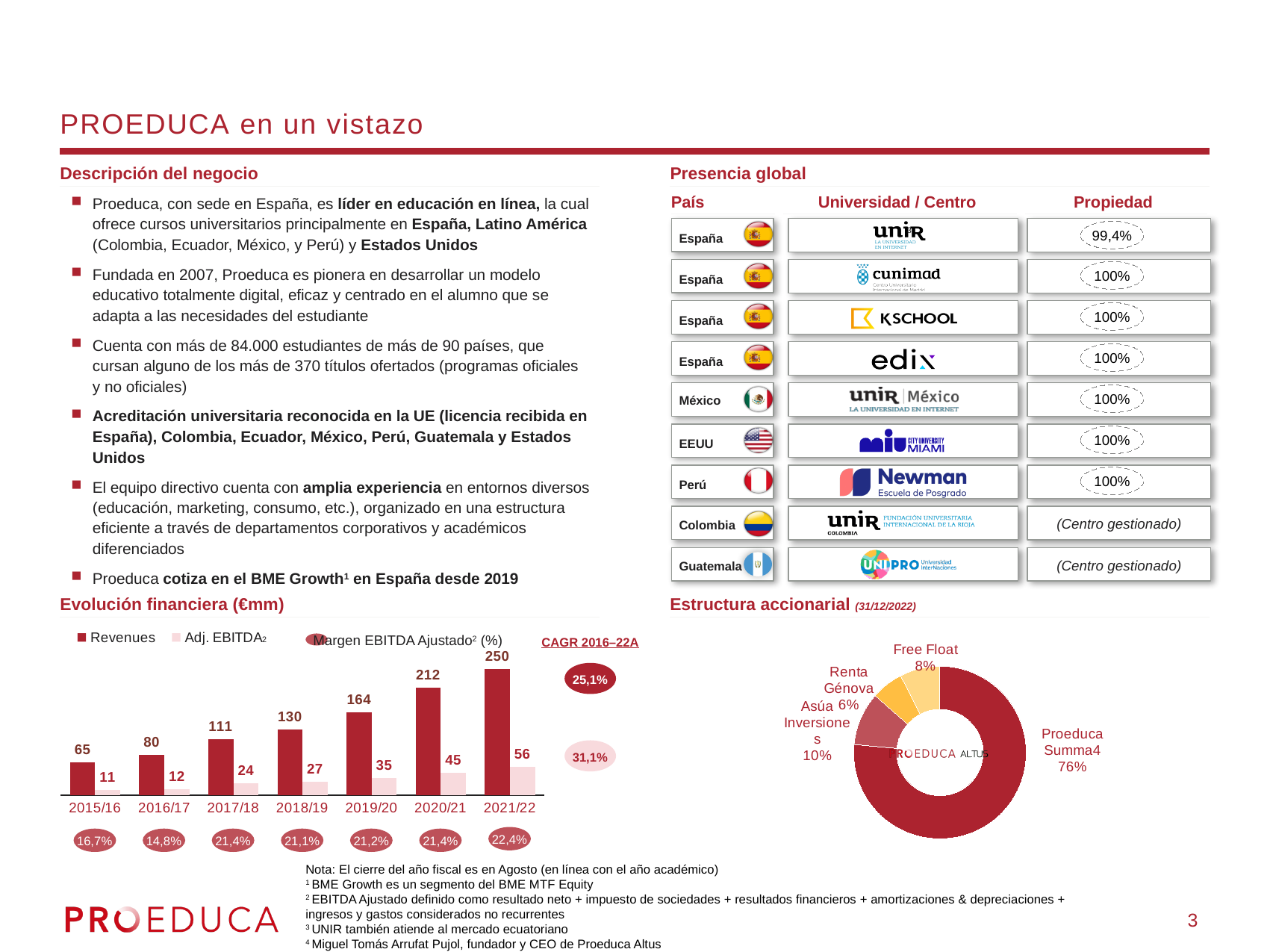
In the 'Evolución financiera (€mm)' chart, what is the difference between Revenues in 2020/21 and 2019/20? 48 What type of chart is 'Evolución financiera (€mm)'? bar chart In the 'Evolución financiera (€mm)' chart, which fiscal year has the lowest Revenues? 2015/16 In the 'Evolución financiera (€mm)' chart, what is the Revenues value for 2021/22? 250 In the 'Evolución financiera (€mm)' chart, how many fiscal years are shown on the x axis? 7 In the 'Estructura accionarial' chart, which shareholder has the smallest share? Renta Génova In the 'Evolución financiera (€mm)' chart, what is the Margen EBITDA Ajustado (%) shown for 2021/22? 22,4% In the 'Evolución financiera (€mm)' chart, which is larger: Adj. EBITDA in 2017/18 or Adj. EBITDA in 2016/17? 2017/18 In the 'Evolución financiera (€mm)' chart, what is the Adj. EBITDA value for 2018/19? 27 In the 'Estructura accionarial' chart, what is the difference between the shares of Asúa Inversiones and Free Float? 2% In the 'Estructura accionarial' chart, what share does Proeduca Summa hold? 76% In the 'Evolución financiera (€mm)' chart, do Revenues rise or fall from 2015/16 to 2021/22? rise